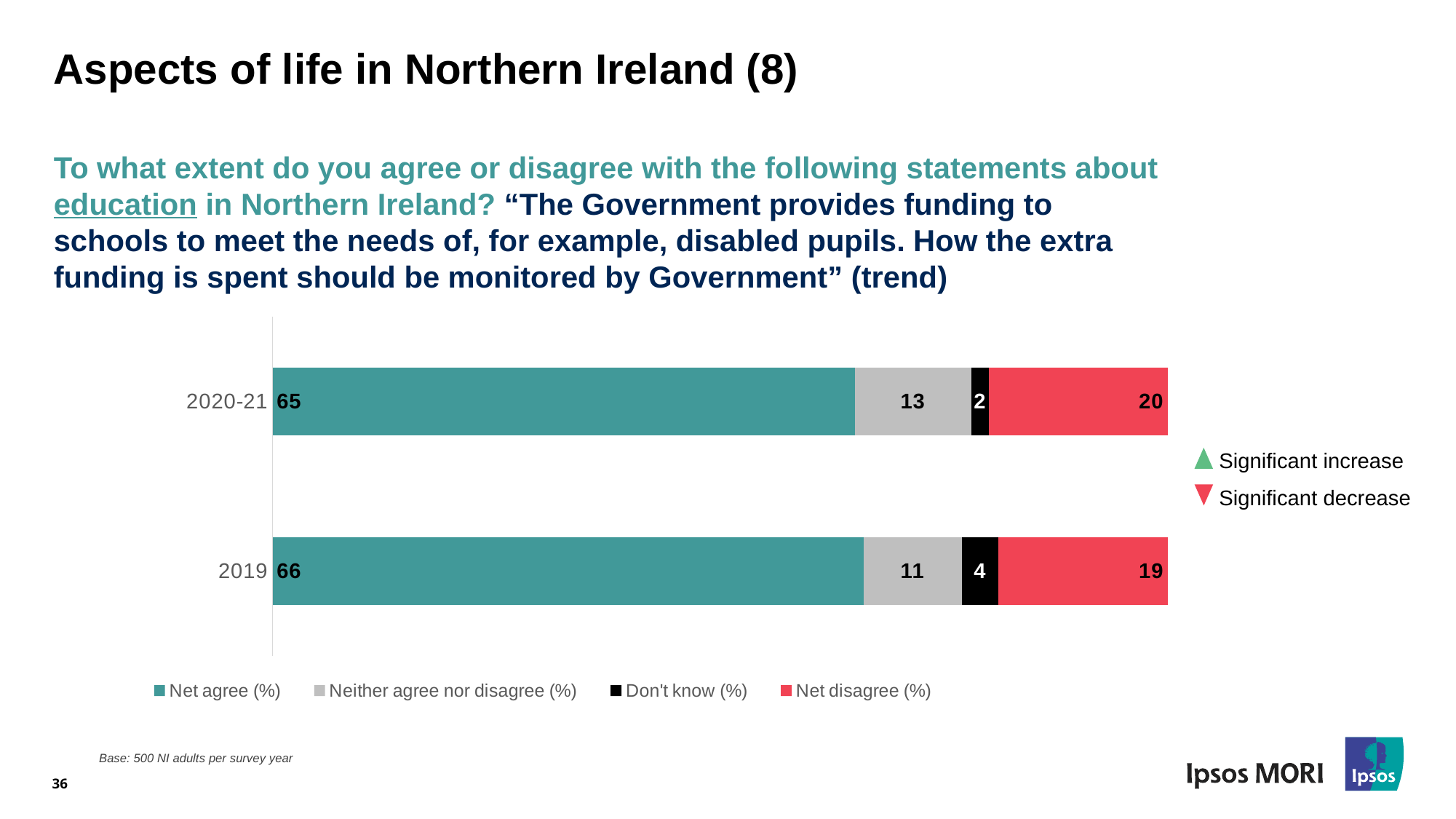
How many survey years are shown in the chart? 2 What is the total of the stacked bar for 2020-21? 100 What is the Neither agree nor disagree (%) value for 2020-21? 13 What is the Net agree (%) value for 2020-21? 65 What kind of chart is shown on the slide? Stacked bar chart What is the difference between the Neither agree nor disagree (%) values for 2020-21 and 2019? 2 Which year has the higher Net agree (%) value? 2019 What is the difference between the Don't know (%) values for 2019 and 2020-21? 2 What is the Don't know (%) value for 2019? 4 How many series does the chart legend list? 4 What is the Net disagree (%) value for 2019? 19 Which series is shown in red in the chart? Net disagree (%)